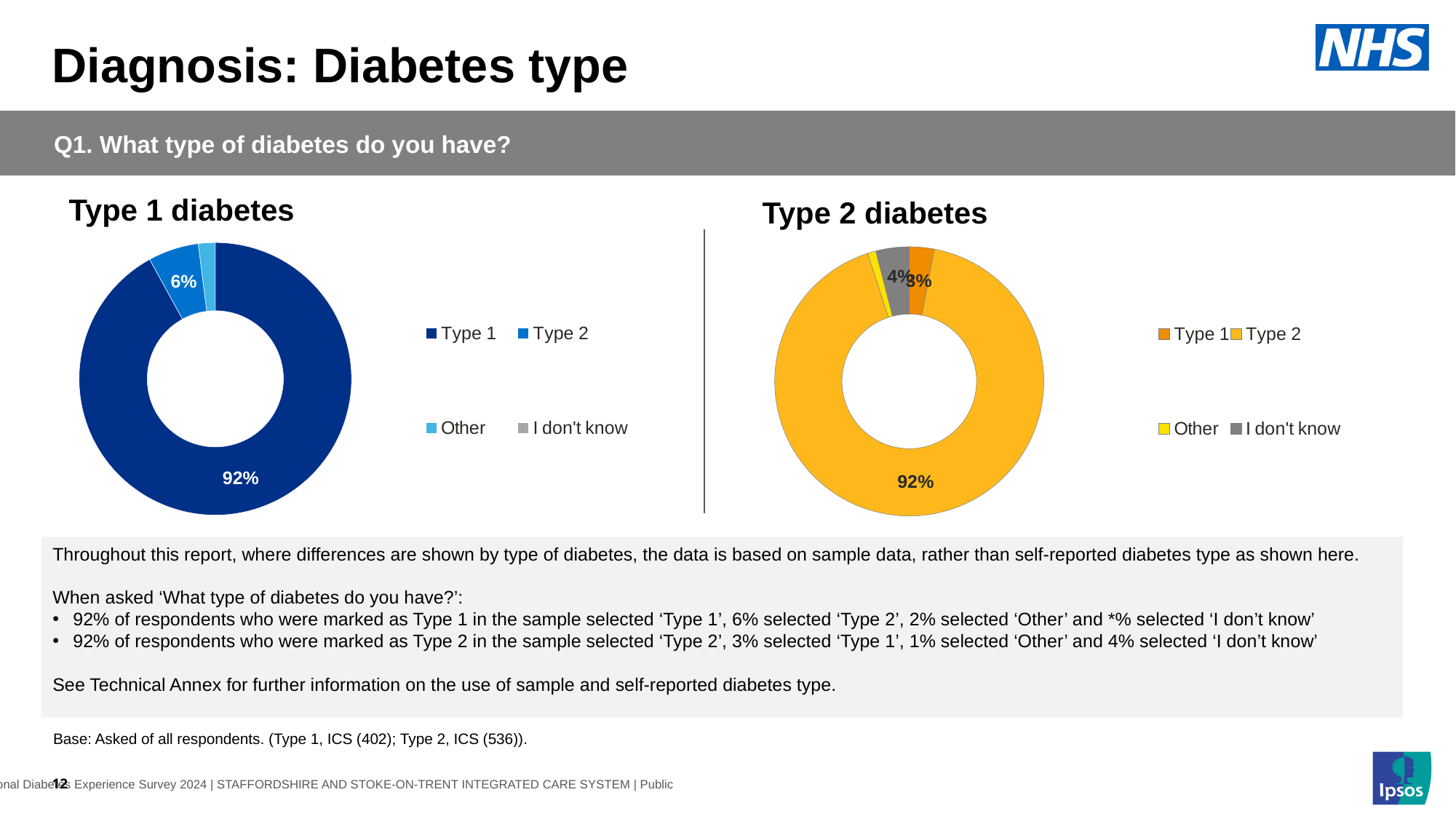
In the Type 1 diabetes chart, what percentage of respondents selected 'Type 2'? 6% In the Type 1 diabetes chart, which category has the largest share? Type 1 In the Type 2 diabetes chart, which is larger: the share for 'I don't know' or the share for 'Type 1'? I don't know In the Type 2 diabetes chart, which category has the largest share? Type 2 What kind of chart is used for the Type 1 diabetes data? Donut (pie) chart In the Type 2 diabetes chart, what colour is the 'Type 2' segment? Yellow-orange (amber) How many categories does the legend of the Type 2 diabetes chart list? 4 In the Type 2 diabetes chart, what percentage of respondents selected 'Type 1'? 3% In the Type 2 diabetes chart, what percentage of respondents selected 'Type 2'? 92% In the Type 1 diabetes chart, what percentage of respondents selected 'Type 1'? 92% In the Type 2 diabetes chart, what percentage of respondents selected 'I don't know'? 4% In the Type 1 diabetes chart, what is the difference in percentage points between 'Type 1' and 'Type 2'? 86 percentage points